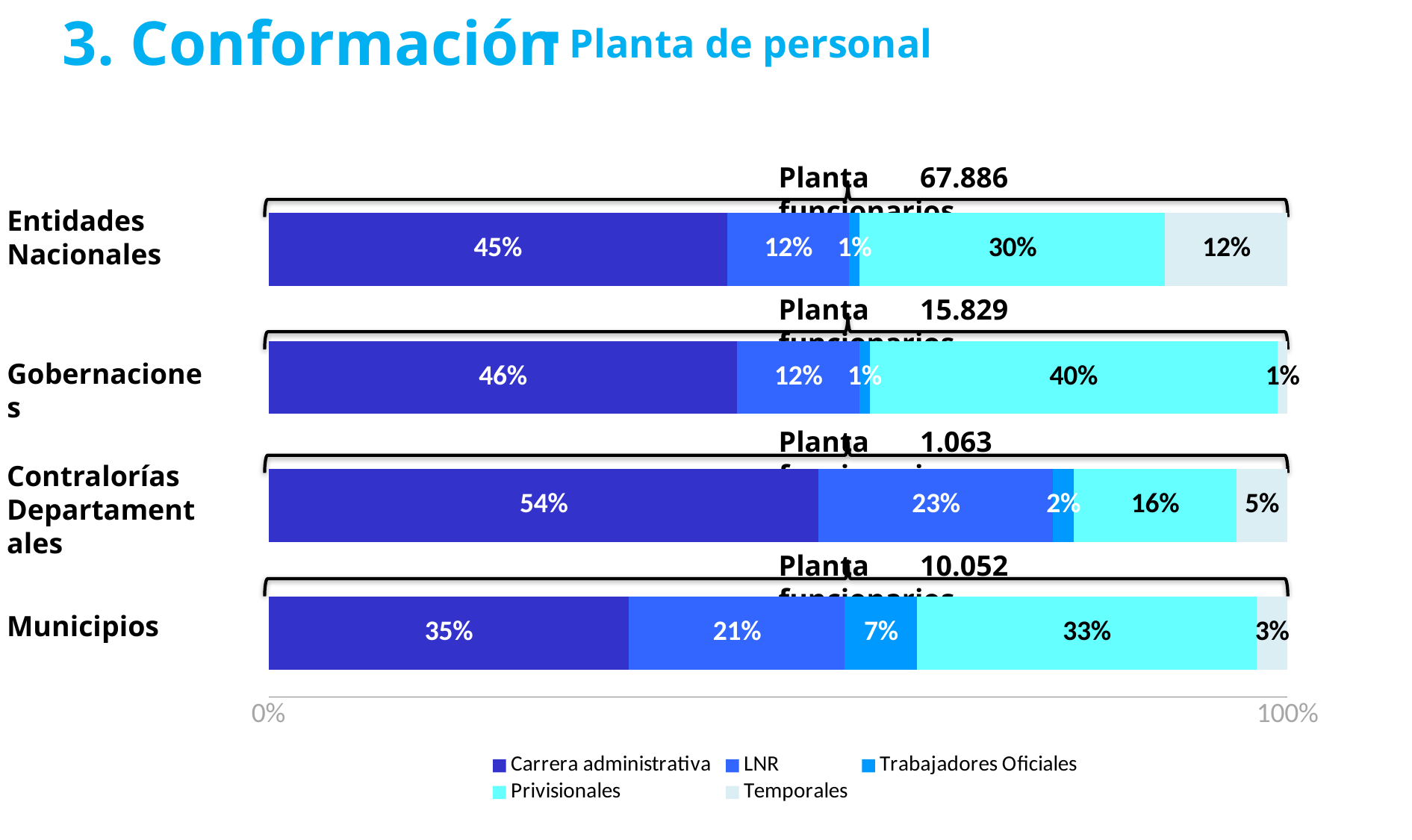
What is the Planta funcionarios figure shown above the Entidades Nacionales bar? 67.886 How many categories (bars) are shown in the chart? 4 What is the difference between the LNR share for Contralorías Departamentales and the LNR share for Entidades Nacionales? 11% What is the Trabajadores Oficiales share for Municipios? 7% What is the Temporales share for Entidades Nacionales? 12% Which category has the highest Carrera administrativa share? Contralorías Departamentales What kind of chart is shown on the slide? Stacked bar chart How many series does the legend list? 5 What is the Carrera administrativa share for Contralorías Departamentales? 54% What is the Privisionales share for Gobernaciones? 40% Which is larger: the Privisionales share for Municipios or the Privisionales share for Entidades Nacionales? Municipios Which category has the lowest Carrera administrativa share? Municipios